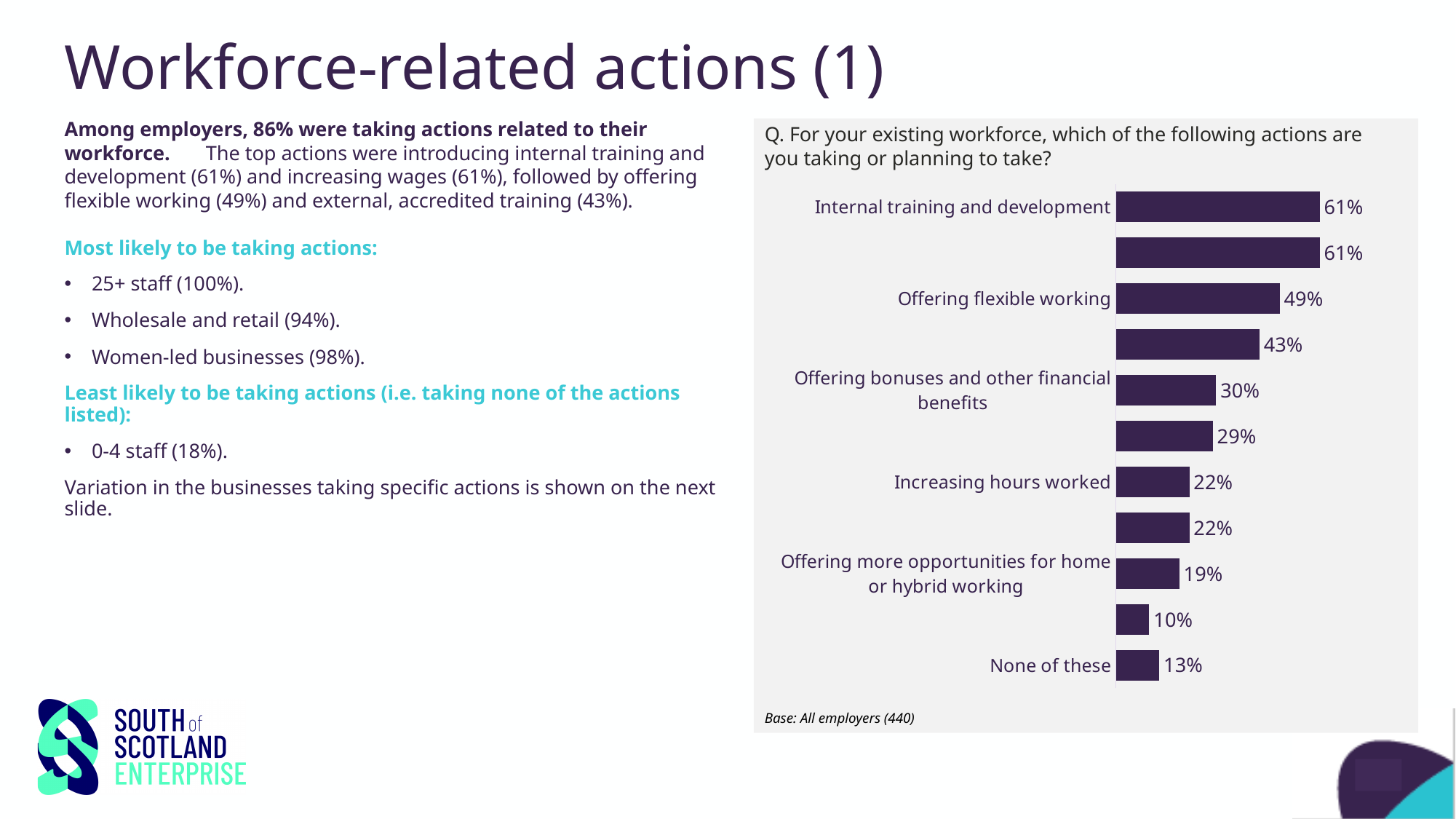
How many bars are plotted in the chart? 11 How many percentage points higher is 'Internal training and development' than 'Offering flexible working'? 12% What is the value for 'Increasing hours worked'? 22% What is the value shown for 'Offering flexible working'? 49% What base is stated beneath the chart? All employers (440) What is the difference between 'Offering bonuses and other financial benefits' and 'Increasing hours worked'? 8% What type of chart is shown on the slide? Bar chart Which has the larger value: 'Offering flexible working' or 'Offering bonuses and other financial benefits'? Offering flexible working What percentage of employers are taking or planning to take the action 'Internal training and development'? 61% What is the value shown for 'None of these'? 13% What percentage is shown for 'Offering bonuses and other financial benefits'? 30% What percentage of employers are 'Offering more opportunities for home or hybrid working'? 19%